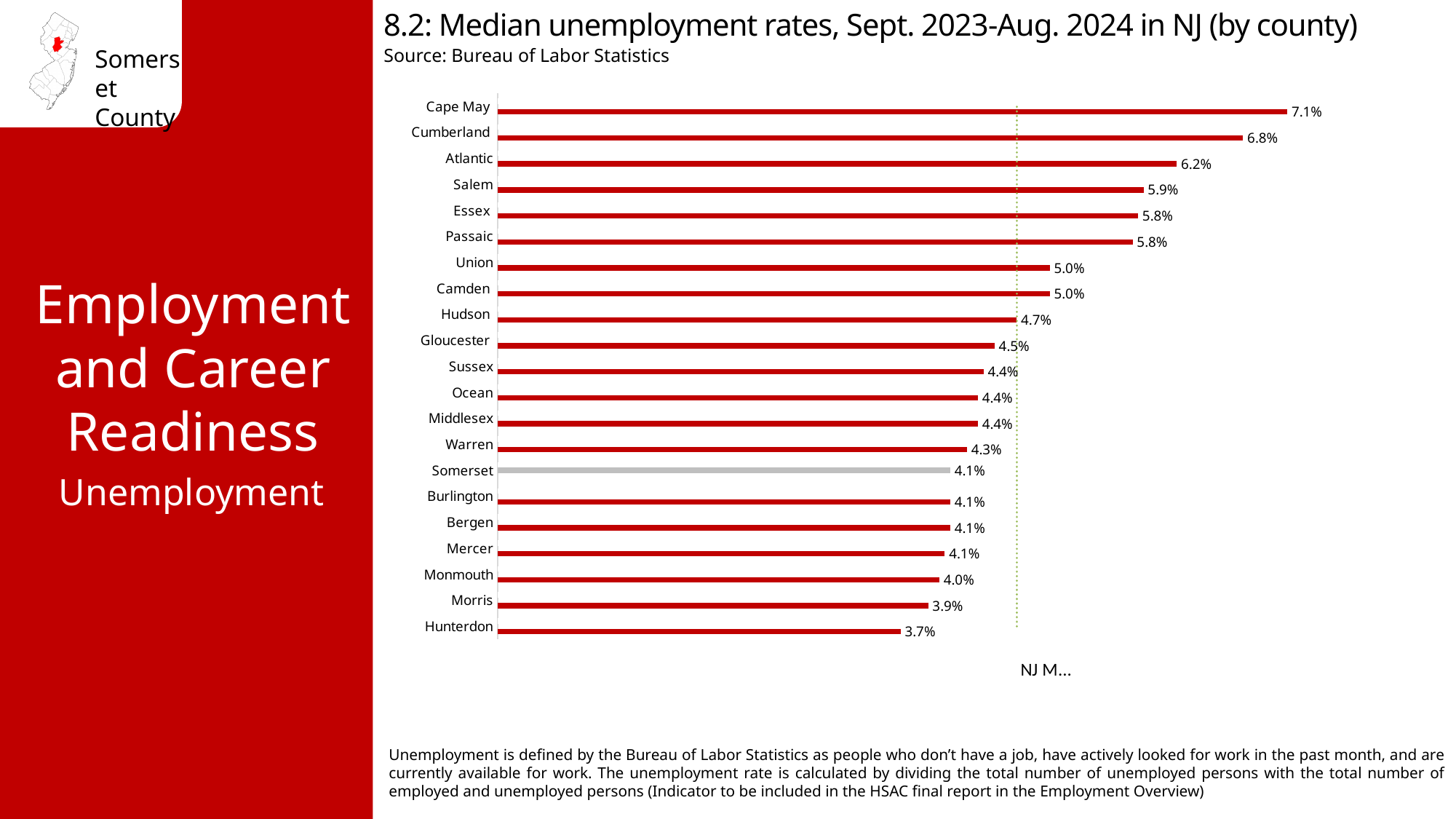
How many counties are shown in the chart? 21 Which county has a higher median unemployment rate, Morris or Monmouth? Monmouth What kind of chart is used to show the median unemployment rates? Bar chart What is the difference between the median unemployment rates of Cape May and Hunterdon? 3.4% Which county's bar is shown in grey instead of red? Somerset What is the difference between the median unemployment rates of Cumberland and Somerset? 2.7% Which county has the highest median unemployment rate? Cape May What is the median unemployment rate for Hudson? 4.7% Which county has a higher median unemployment rate, Atlantic or Salem? Atlantic What is the median unemployment rate for Cape May? 7.1% Which county has the lowest median unemployment rate? Hunterdon What is the median unemployment rate for Somerset? 4.1%